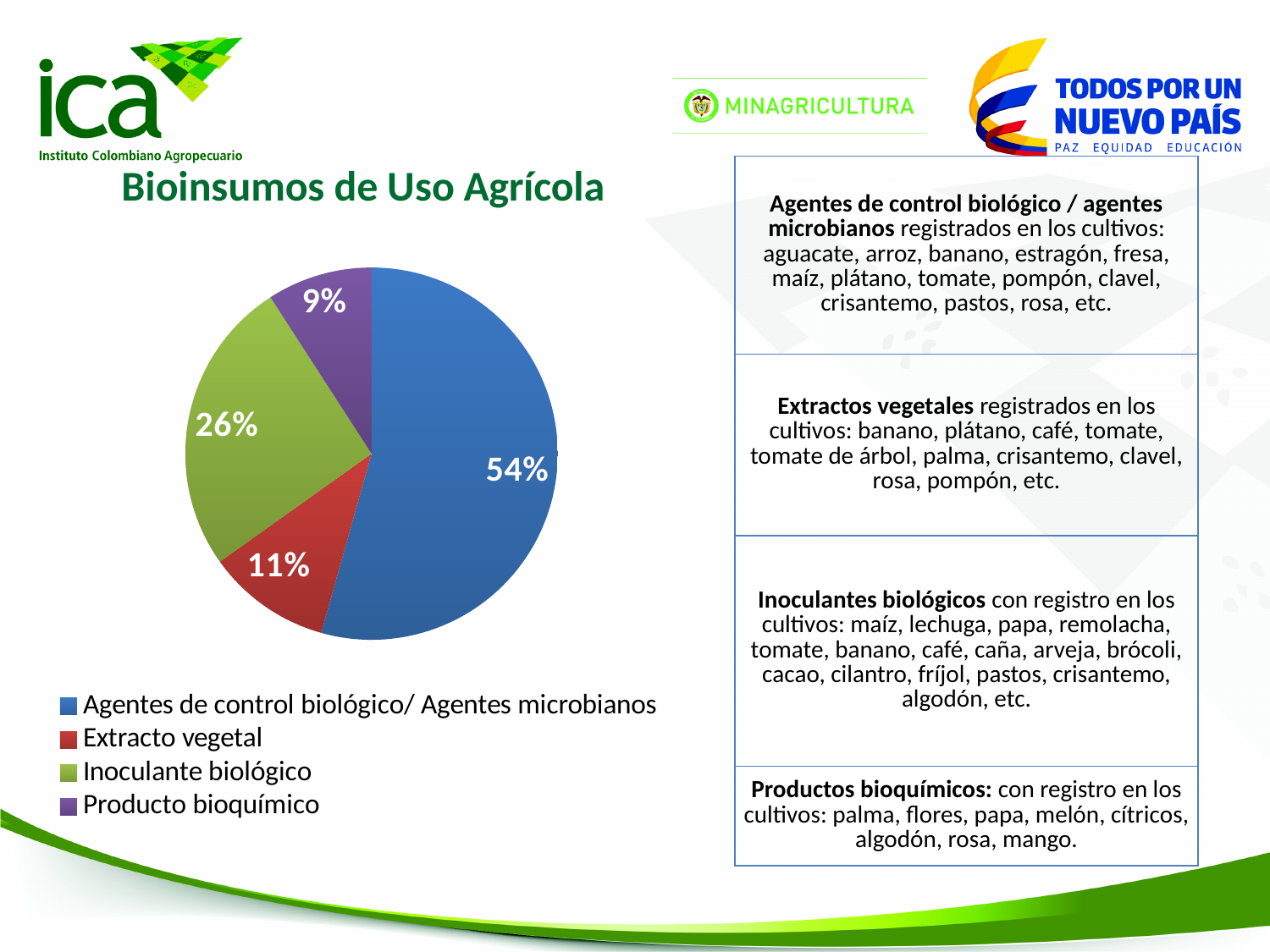
How many categories does the pie chart show? 4 What is the title of the chart? Bioinsumos de Uso Agrícola What share of the pie does Agentes de control biológico/ Agentes microbianos have? 54% What colour is the slice for Inoculante biológico? green What is the difference in percentage points between Inoculante biológico and Extracto vegetal? 15 What kind of chart is shown on the slide? pie chart Which category has the smallest slice of the pie? Producto bioquímico What share of the pie does Extracto vegetal have? 11% Which is larger, the share for Extracto vegetal or the share for Producto bioquímico? Extracto vegetal Which category has the largest slice of the pie? Agentes de control biológico/ Agentes microbianos What share of the pie does Producto bioquímico have? 9%